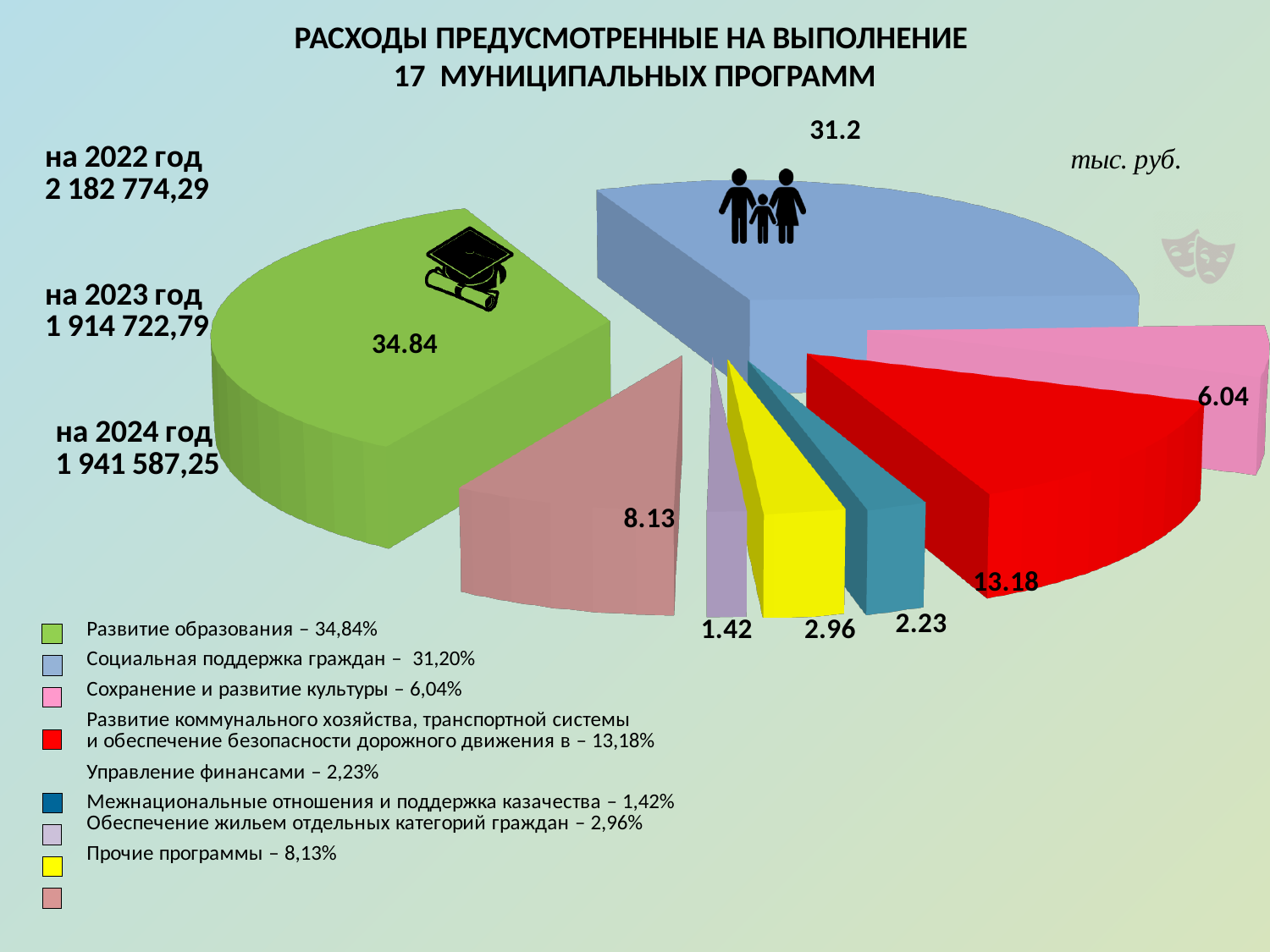
What unit is indicated in the top right of the chart? тыс. руб. Which category has the smallest share of the pie? Межнациональные отношения и поддержка казачества Which category has the largest share of the pie? Развитие образования Which is larger: the slice for Прочие программы or the slice for Сохранение и развитие культуры? Прочие программы What kind of chart is shown on the slide? pie chart How many slices does the pie chart have? 8 What value is printed on the slice for Социальная поддержка граждан? 31.2 What is the difference between the values for Развитие образования (34.84) and Социальная поддержка граждан (31.2)? 3.64 What is the value shown for the largest slice of the pie (Развитие образования)? 34.84 What value is printed on the red slice (Развитие коммунального хозяйства, транспортной системы и обеспечение безопасности дорожного движения)? 13.18 What percentage does the legend give for Управление финансами? 2,23% What total expenditure is shown for 2022 (на 2022 год)? 2 182 774,29